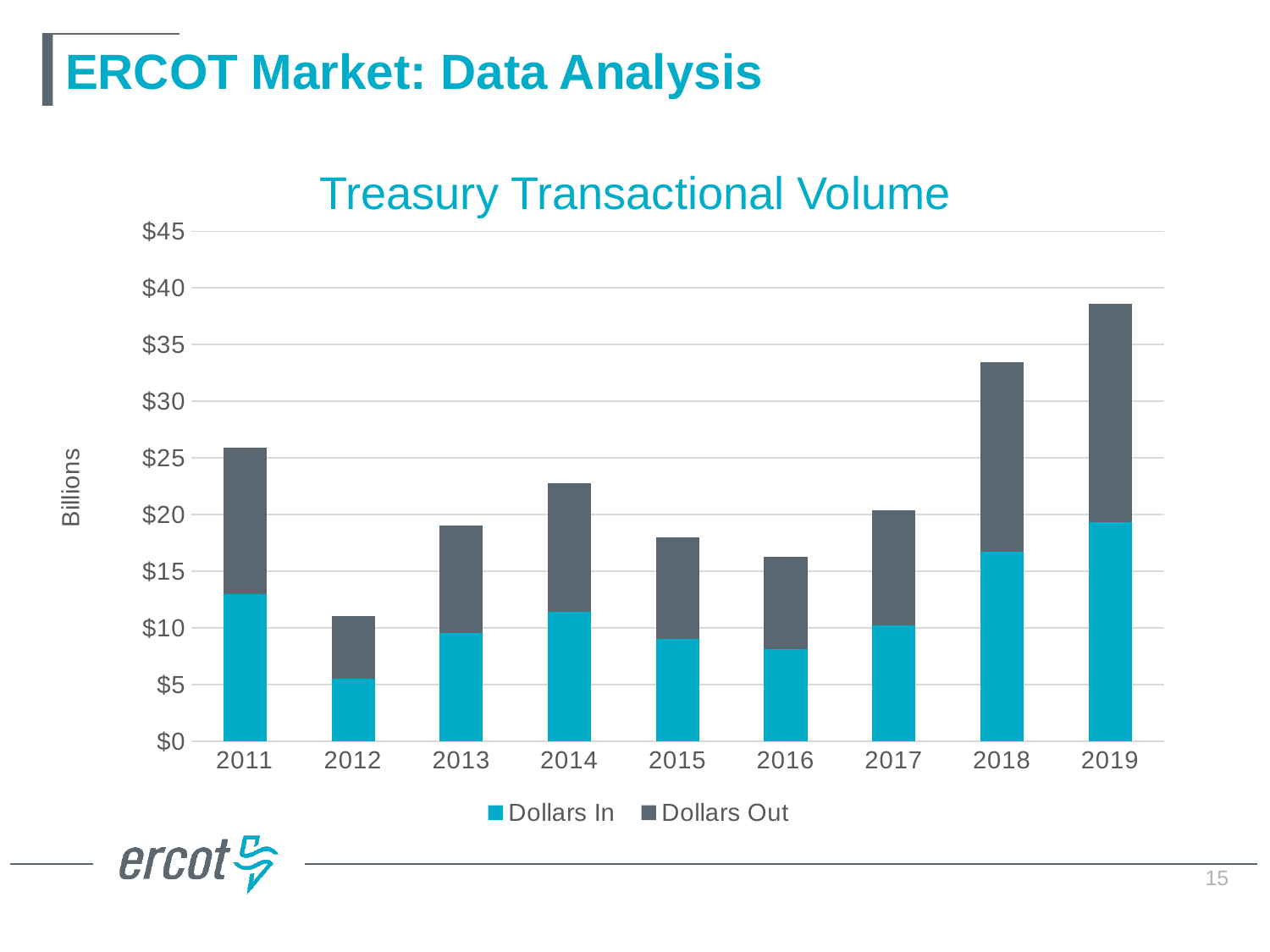
Is the Dollars In value for 2019 greater or less than $15? greater What kind of chart is shown on the slide? Stacked bar chart Which year has the larger total bar, 2017 or 2018? 2018 Which year has the highest total Treasury Transactional Volume? 2019 How many series does the legend list? 2 Is the total bar for 2019 greater or less than $35? greater What is the title of the chart? Treasury Transactional Volume How many years are shown on the x axis of the Treasury Transactional Volume chart? 9 Which year has the larger Dollars In value, 2011 or 2012? 2011 What is the label on the vertical axis of the chart? Billions Is the total bar for 2012 greater or less than $15? less Which year has the lowest total Treasury Transactional Volume? 2012